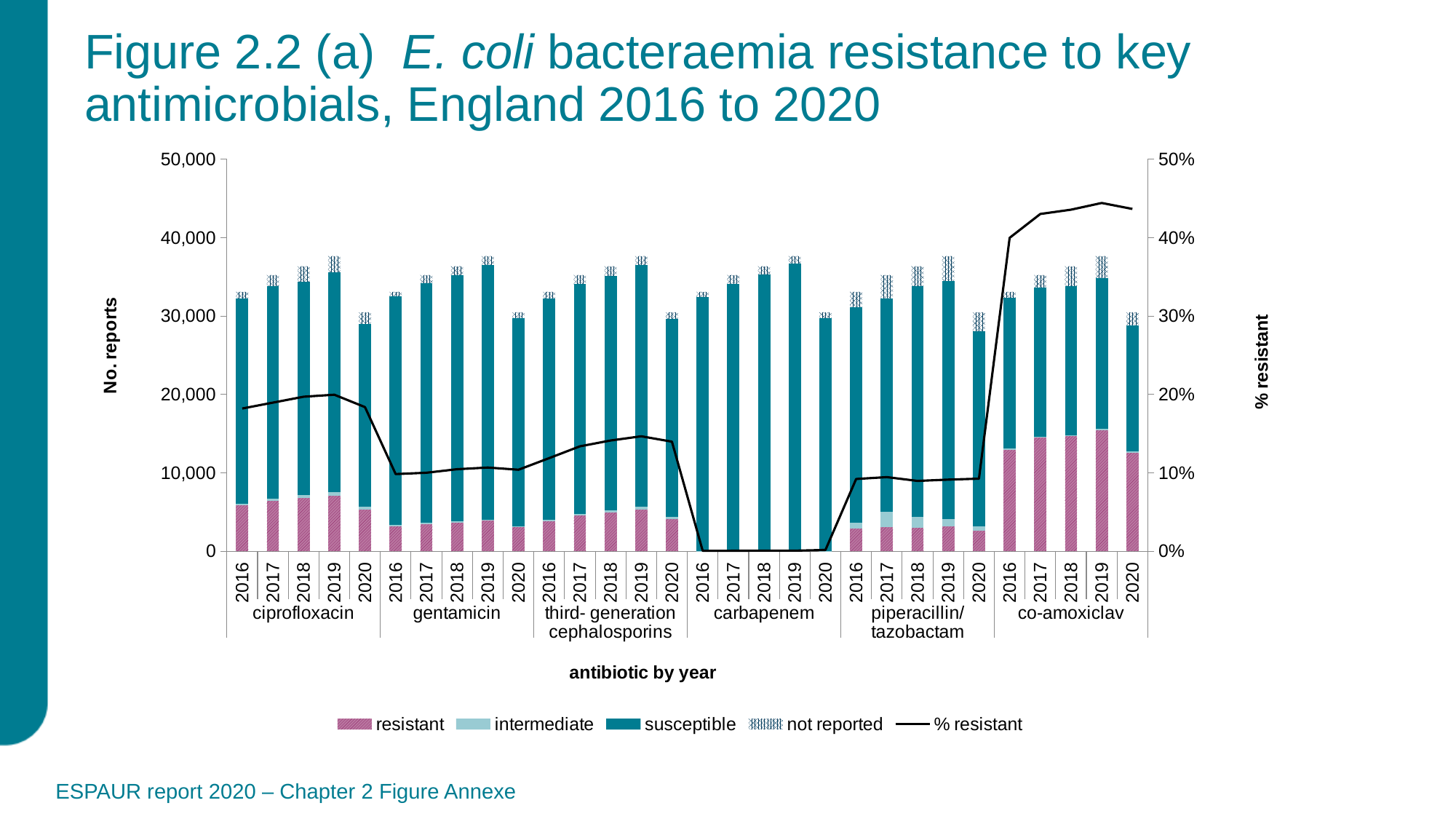
Is the total number of reports for carbapenem in 2019 greater or less than 30,000? greater Is the resistant segment for co-amoxiclav in 2019 greater or less than 10,000 reports? greater Is the % resistant value for co-amoxiclav in 2019 greater or less than 40%? greater How many series does the legend list? 5 What is the label of the right-hand vertical axis? % resistant Which antibiotic has the highest % resistant values on the chart? co-amoxiclav How many bars are plotted in total on the chart? 30 How many antibiotic groups are shown along the x axis? 6 Does the % resistant line for co-amoxiclav rise or fall from 2016 to 2019? rise What kind of chart is shown on the slide? stacked bar chart with a line